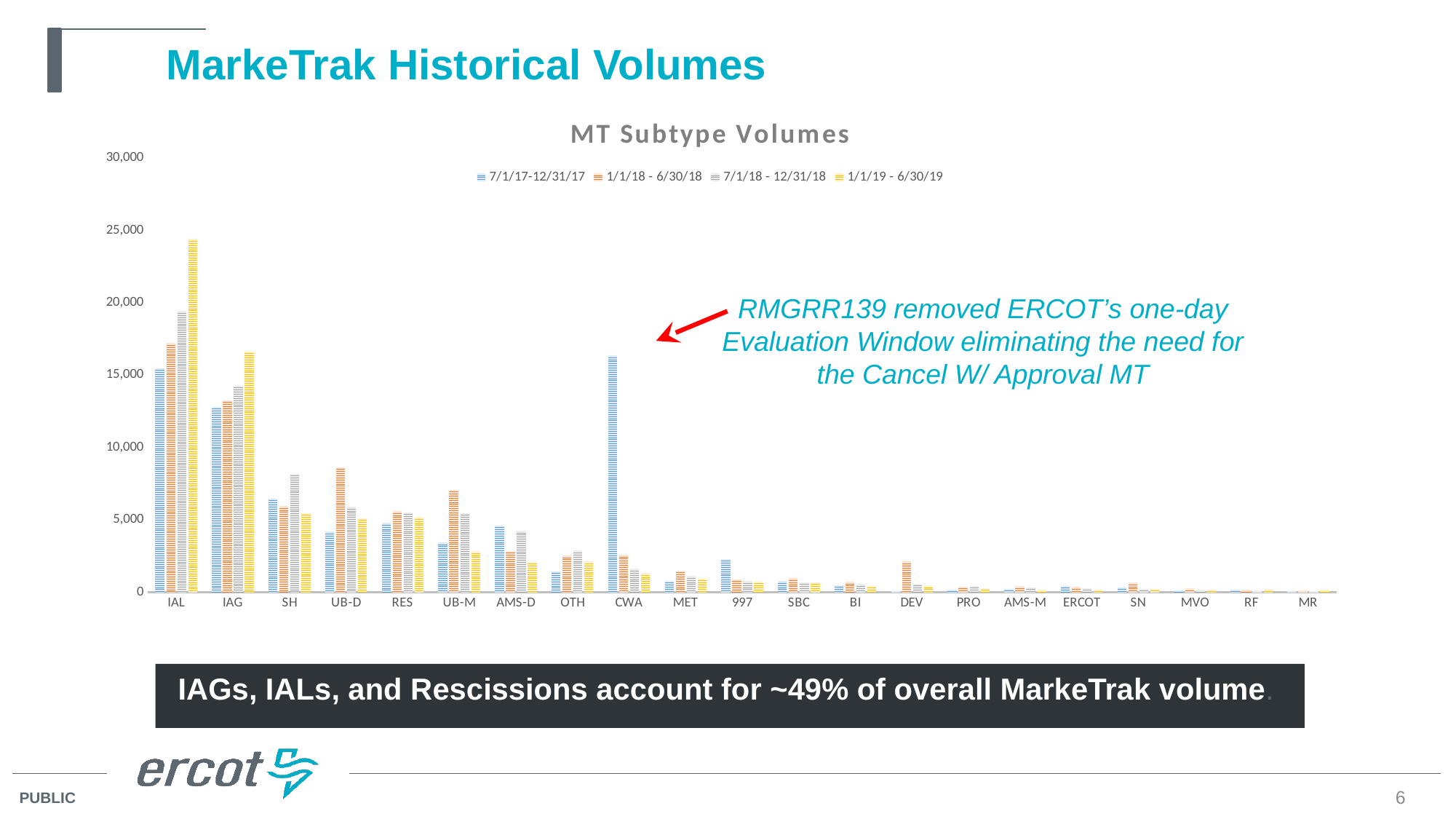
For CWA, which period has the highest volume in the MT Subtype Volumes chart? 7/1/17-12/31/17 Which period does the yellow series in the MT Subtype Volumes chart represent? 1/1/19 - 6/30/19 For IAL, which period has the highest volume in the MT Subtype Volumes chart? 1/1/19 - 6/30/19 How many series does the legend of the MT Subtype Volumes chart list? 4 How many MT subtype categories are shown on the x axis of the MT Subtype Volumes chart? 21 Is the 7/1/17-12/31/17 value for CWA greater or less than 15,000? greater Which is larger in the MT Subtype Volumes chart: the 1/1/19 - 6/30/19 value for IAL or the 1/1/19 - 6/30/19 value for IAG? IAL What is the title of the chart on the slide? MT Subtype Volumes Which category has the tallest bar in the MT Subtype Volumes chart? IAL Is the 1/1/18 - 6/30/18 value for UB-D greater or less than 5,000? greater What kind of chart is the MT Subtype Volumes chart? bar chart Is the 1/1/19 - 6/30/19 value for IAL greater or less than 20,000? greater